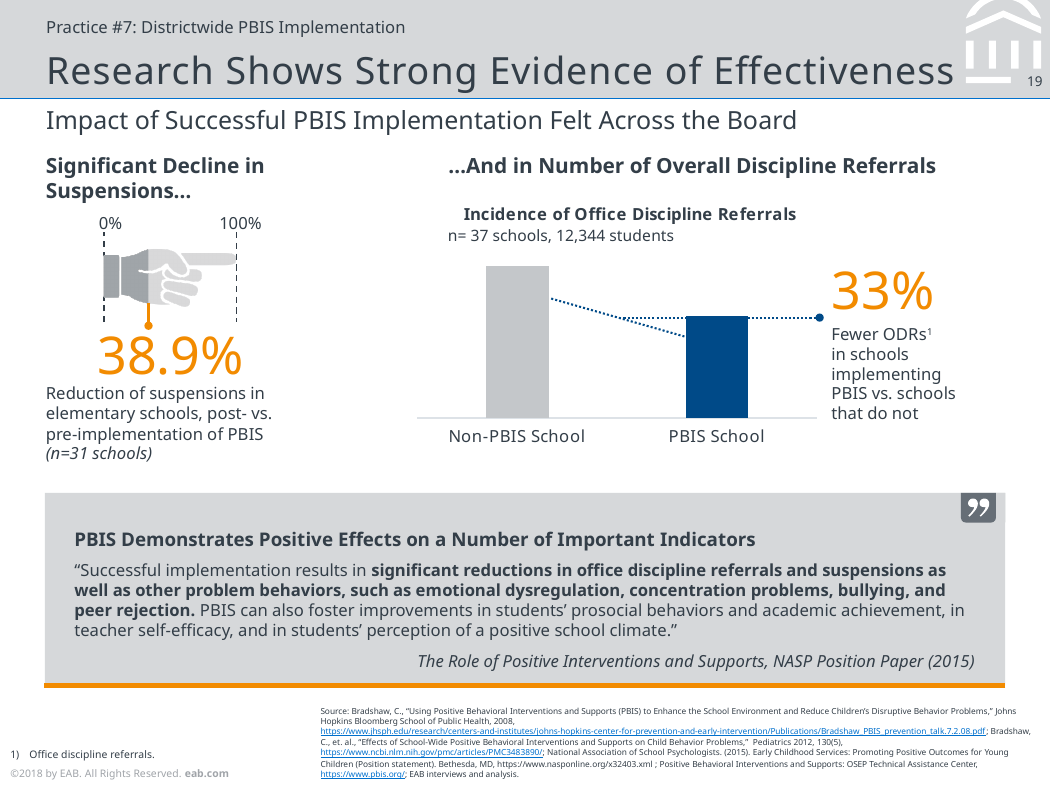
How many schools and students does the subtitle of the 'Incidence of Office Discipline Referrals' chart say the data covers? n= 37 schools, 12,344 students In the 'Incidence of Office Discipline Referrals' chart, is the bar for Non-PBIS School or PBIS School larger? Non-PBIS School What is the title of the bar chart on the slide? Incidence of Office Discipline Referrals What kind of chart is the 'Incidence of Office Discipline Referrals' chart? bar chart How many categories are shown on the x axis of the 'Incidence of Office Discipline Referrals' chart? 2 According to the annotation next to the 'Incidence of Office Discipline Referrals' chart, by what percentage are ODRs fewer in schools implementing PBIS vs. schools that do not? 33% What are the two category labels on the x axis of the 'Incidence of Office Discipline Referrals' chart? Non-PBIS School and PBIS School In the 'Incidence of Office Discipline Referrals' chart, which category has the taller bar? Non-PBIS School In the 'Incidence of Office Discipline Referrals' chart, which category has the shorter bar? PBIS School